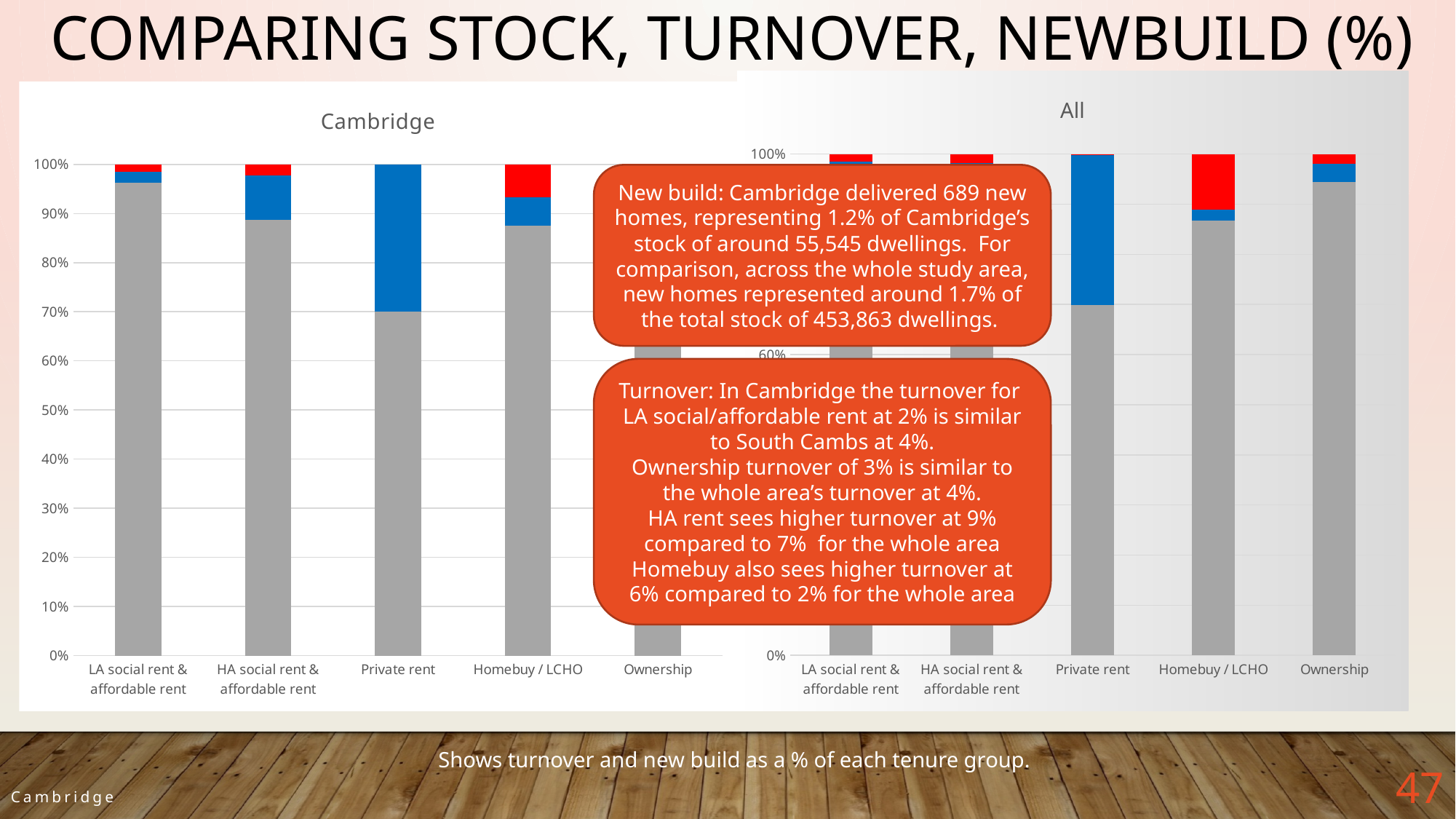
In the All chart, is the grey segment for Ownership greater or less than 90%? greater In the All chart, is the grey segment for Private rent greater or less than 80%? less In the Cambridge chart, is the blue segment larger for Private rent or for Homebuy / LCHO? Private rent In the Cambridge chart, which category has the smallest grey segment? Private rent In the All chart, which category has the largest red segment? Homebuy / LCHO In the Cambridge chart, is the grey segment for LA social rent & affordable rent greater or less than 90%? greater In the Cambridge chart, which category has the largest blue segment? Private rent How many tenure categories are shown on the x axis of the Cambridge chart? 5 How many tenure categories are shown on the x axis of the All chart? 5 What is the title of the chart on the right of the slide? All What kind of chart is the Cambridge chart on the left? Stacked bar chart